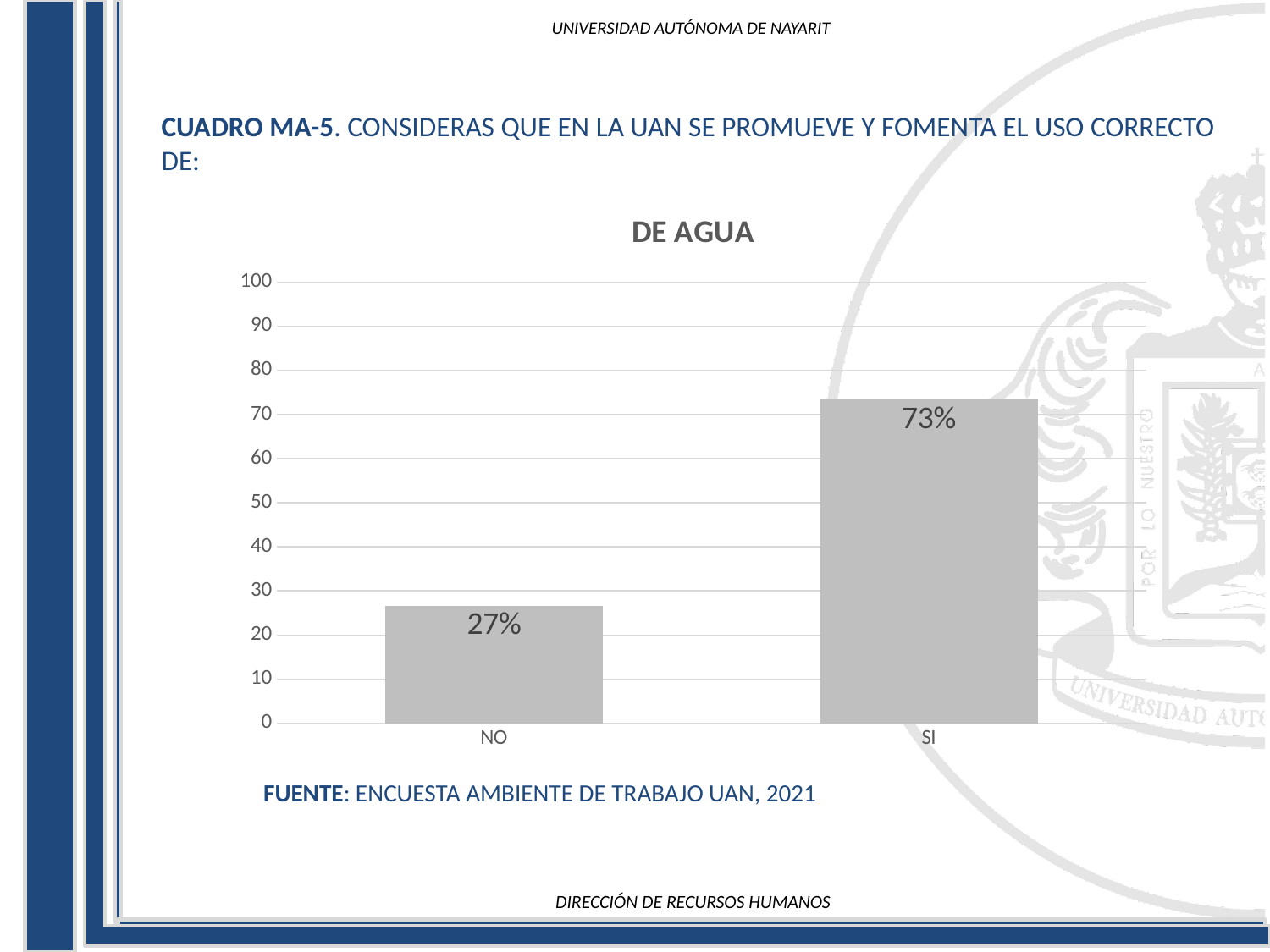
What kind of chart is shown on the slide? bar chart Which category has the highest value? SI What is the value for SI? 73% Is the value for NO greater or less than 30? less What is the difference between the values for SI and NO? 46% What is the highest value shown on the y axis? 100 Which is larger, the value for NO or the value for SI? SI What is the title of the chart? DE AGUA What is the value for NO? 27% Which category has the lowest value? NO How many categories are shown on the x axis? 2 Is the value for SI greater or less than 70? greater